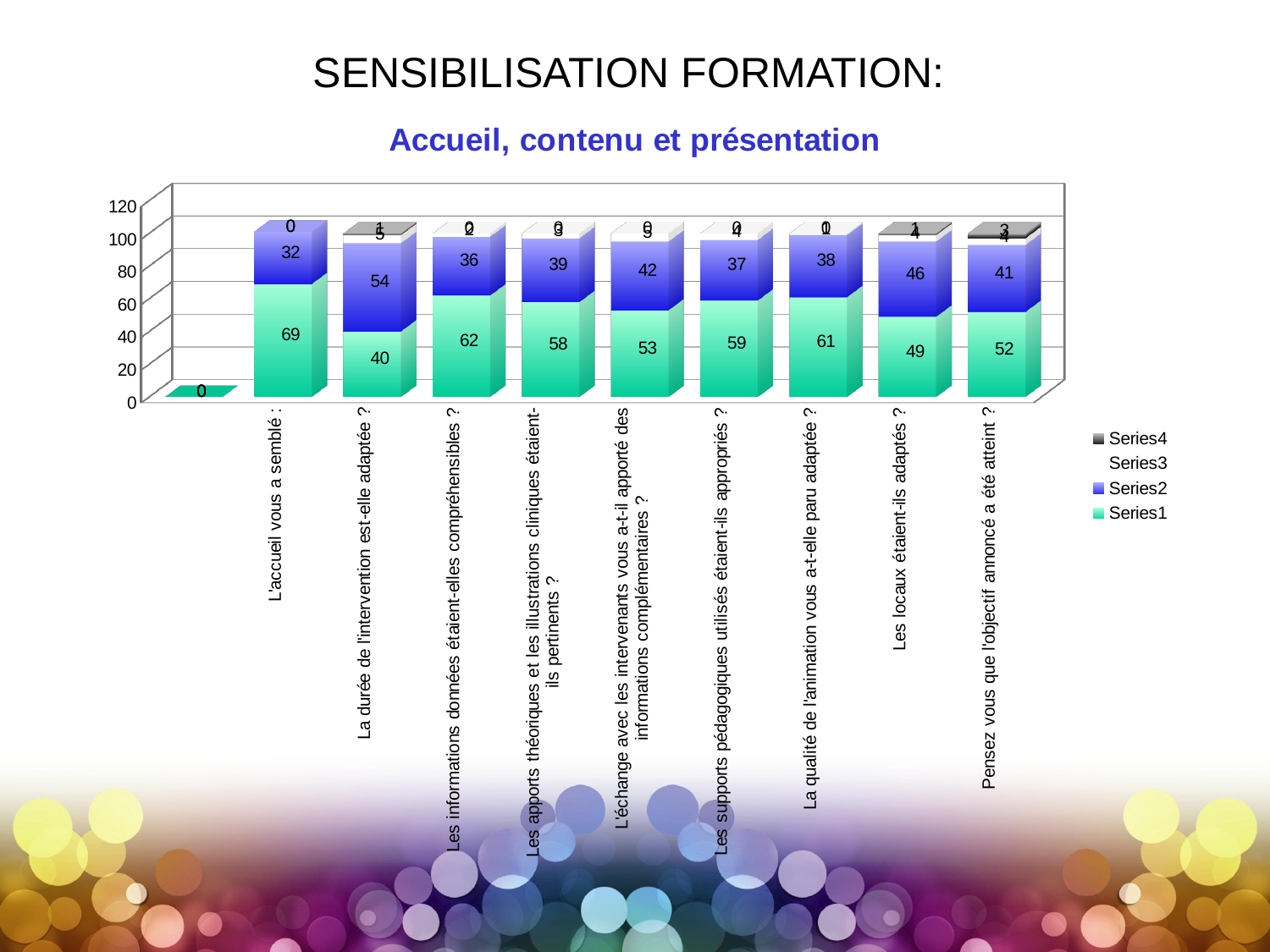
What is the Series1 value for "L'accueil vous a semblé :"? 69 What is the Series1 value for "Les locaux étaient-ils adaptés ?"? 49 Which category has the highest Series2 value? La durée de l'intervention est-elle adaptée ? What kind of chart is shown on the slide? Stacked bar chart What is the difference between the Series1 values for "L'accueil vous a semblé :" and "La durée de l'intervention est-elle adaptée ?"? 29 What is the subtitle shown above the chart? Accueil, contenu et présentation Which has the larger Series1 value: "Les informations données étaient-elles compréhensibles ?" or "Les apports théoriques et les illustrations cliniques étaient-ils pertinents ?"? Les informations données étaient-elles compréhensibles ? How many series does the legend list? 4 What is the Series2 value for "La durée de l'intervention est-elle adaptée ?"? 54 What is the Series2 value for "Pensez vous que l'objectif annoncé a été atteint ?"? 41 Which category has the highest Series1 value? L'accueil vous a semblé :